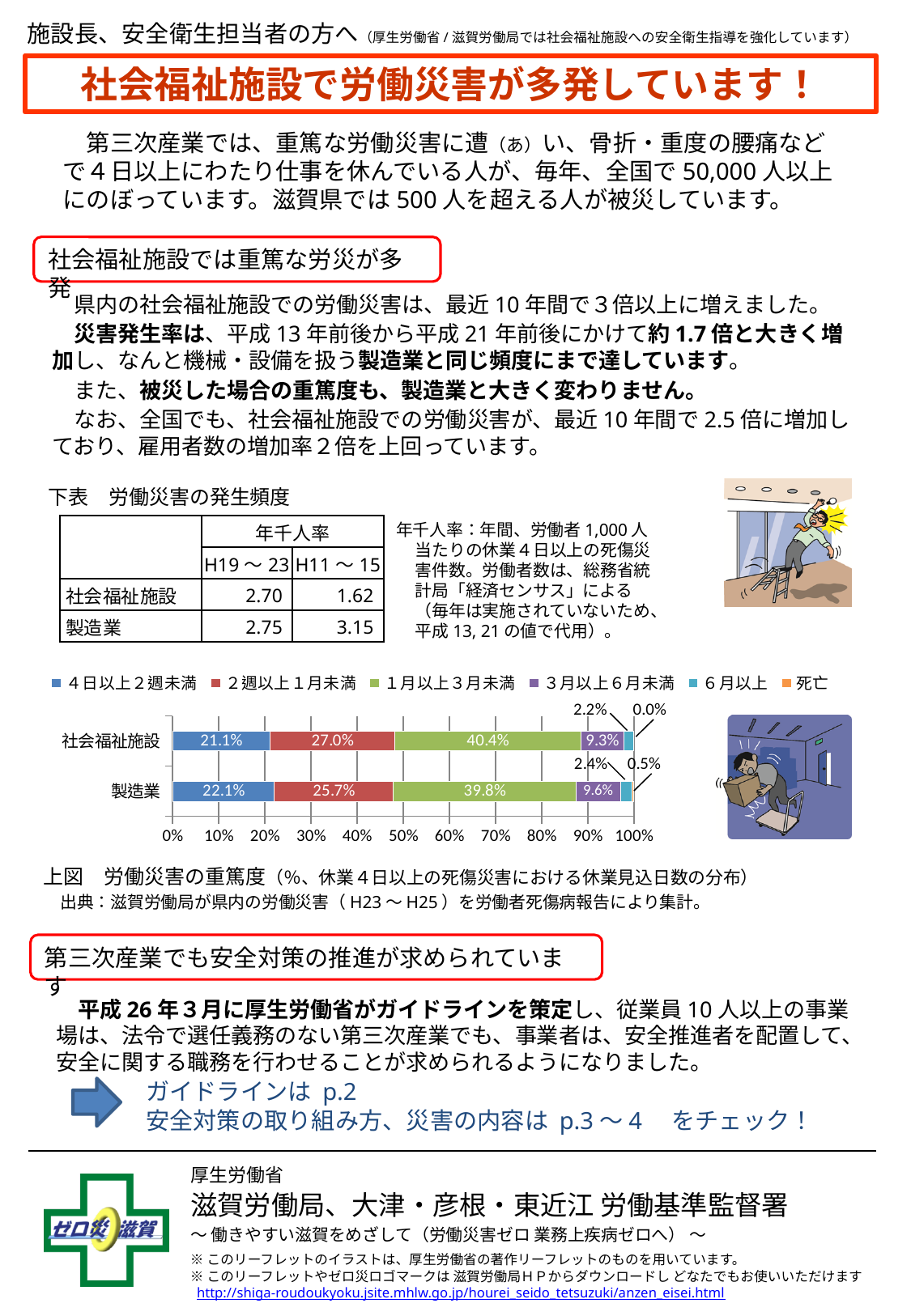
What type of chart is shown on the slide? Stacked bar chart How many categories are plotted on the bar chart? 2 How many series does the legend of the bar chart list? 6 In the bar chart, which segment is the smallest for 製造業? 死亡 In the bar chart, what is the value of 6月以上 for 社会福祉施設? 2.2% In the bar chart, what is the value of 4日以上2週未満 for 社会福祉施設? 21.1% In the bar chart, what is the value of 2週以上1月未満 for 社会福祉施設? 27.0% In the bar chart, which segment is the largest for 社会福祉施設? 1月以上3月未満 In the bar chart, which category has the larger value for 3月以上6月未満, 社会福祉施設 or 製造業? 製造業 In the bar chart, what is the value of 死亡 for 製造業? 0.5% In the bar chart, what is the value of 1月以上3月未満 for 製造業? 39.8% In the bar chart, what is the difference between the 2週以上1月未満 values for 社会福祉施設 and 製造業? 1.3%